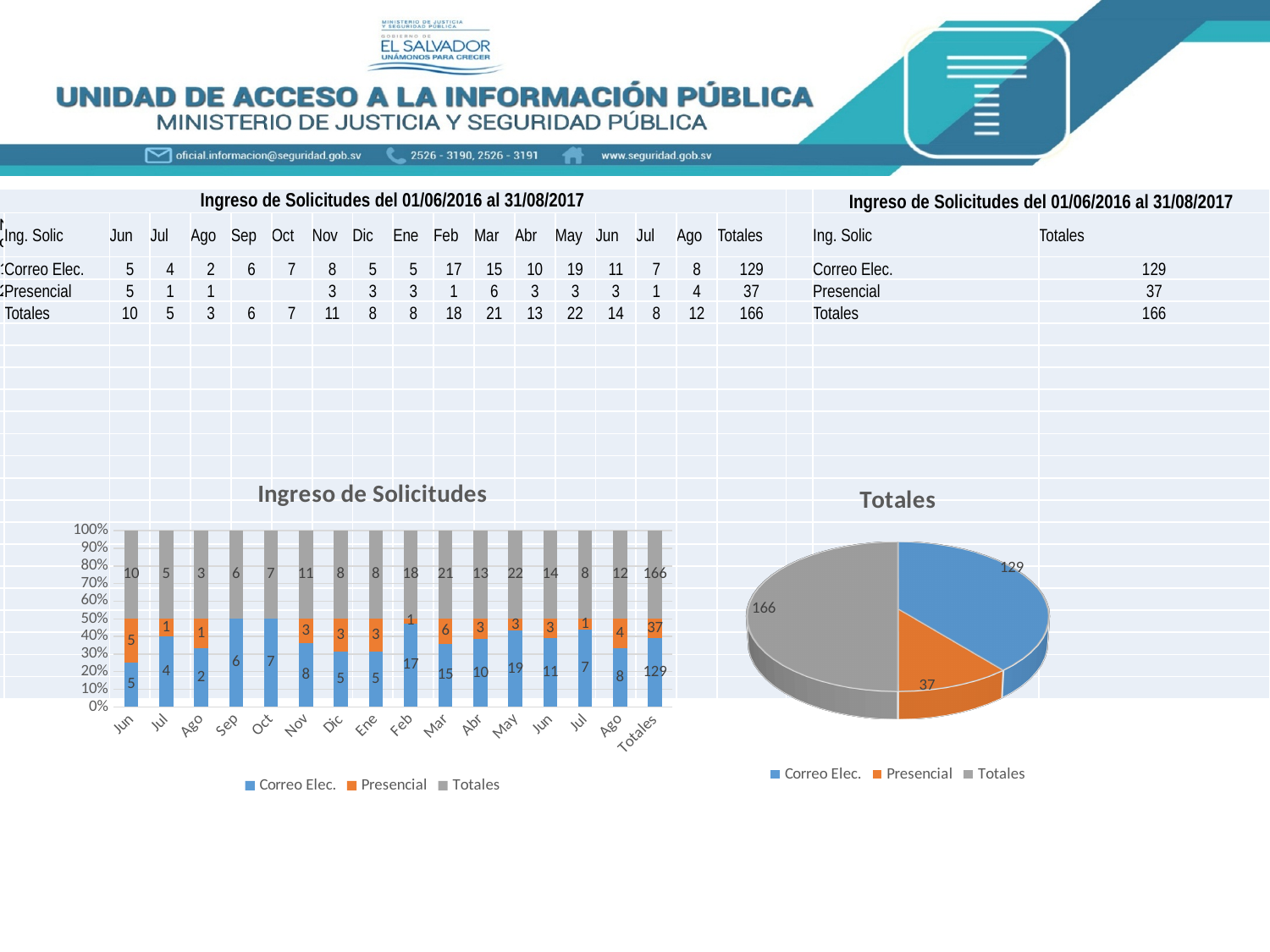
How many categories are shown on the x axis of the "Ingreso de Solicitudes" chart? 16 In the "Totales" pie chart, what is the value of the Presencial slice? 37 In the "Totales" pie chart, which slice is larger, Correo Elec. or Presencial? Correo Elec. In the "Totales" pie chart, what is the value of the Correo Elec. slice? 129 In the "Ingreso de Solicitudes" chart, what is the Totales value for May? 22 What kind of chart is the "Totales" chart? pie chart What kind of chart is the "Ingreso de Solicitudes" chart? bar chart In the "Ingreso de Solicitudes" chart, what is the Correo Elec. value for Feb? 17 In the "Ingreso de Solicitudes" chart, what is the difference between the Correo Elec. and Presencial values for Feb? 16 How many series does the legend of the "Ingreso de Solicitudes" chart list? 3 In the "Ingreso de Solicitudes" chart, which month has the highest Totales value? May In the "Ingreso de Solicitudes" chart, what is the Presencial value for Mar? 6